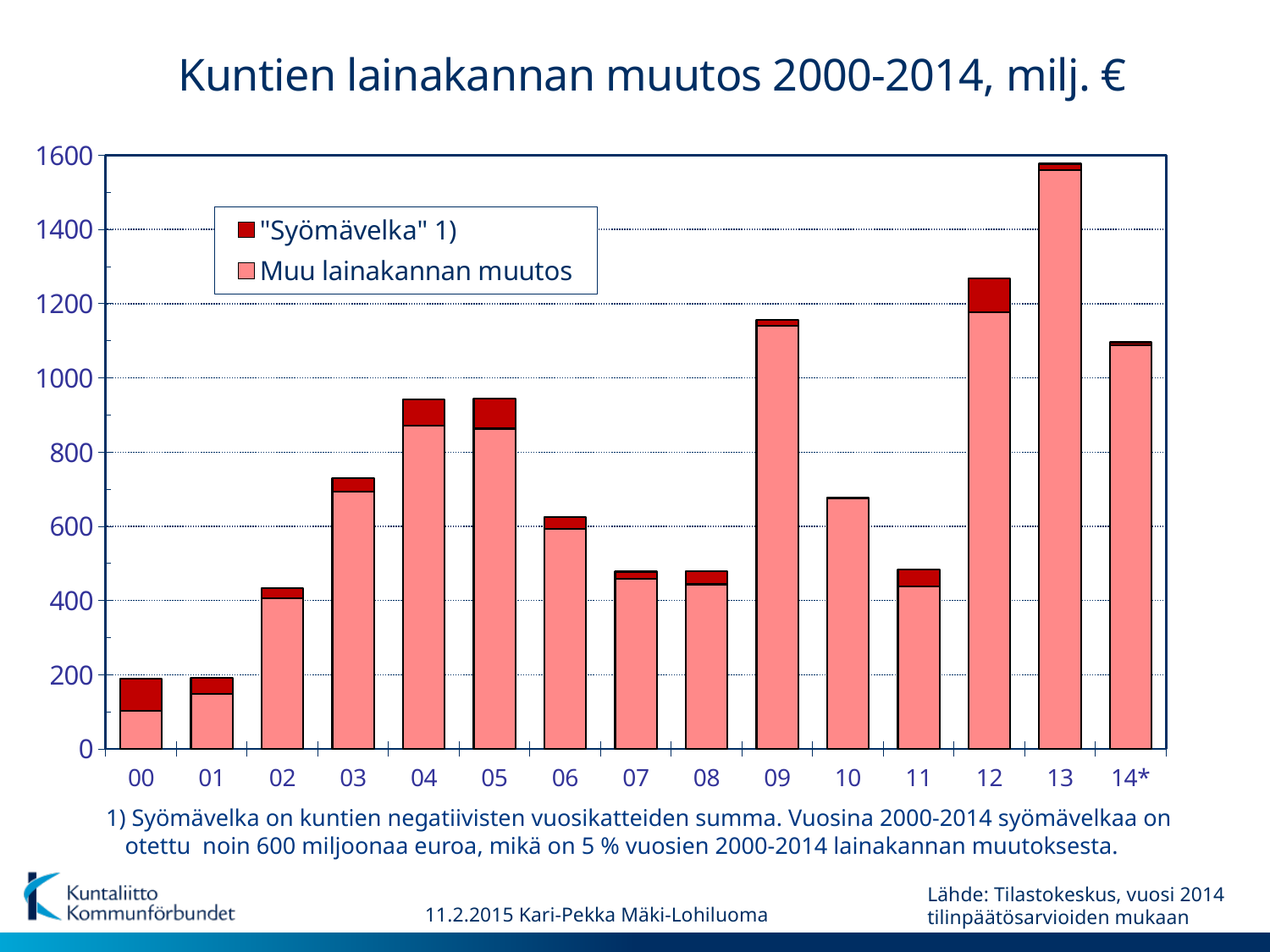
What is the title of the chart? Kuntien lainakannan muutos 2000-2014, milj. € Is the total value for 10 greater or less than 800? less Which year has the highest total bar? 13 What kind of chart is shown on the slide? Stacked bar chart Which has the larger total bar, 09 or 10? 09 Is the total value for 07 greater or less than 600? less How many years (categories) are shown on the x axis? 15 Do the total bars rise or fall from 11 to 13? rise How many series does the legend list? 2 Is the total value for 13 greater or less than 1400? greater Which has the larger total bar, 06 or 07? 06